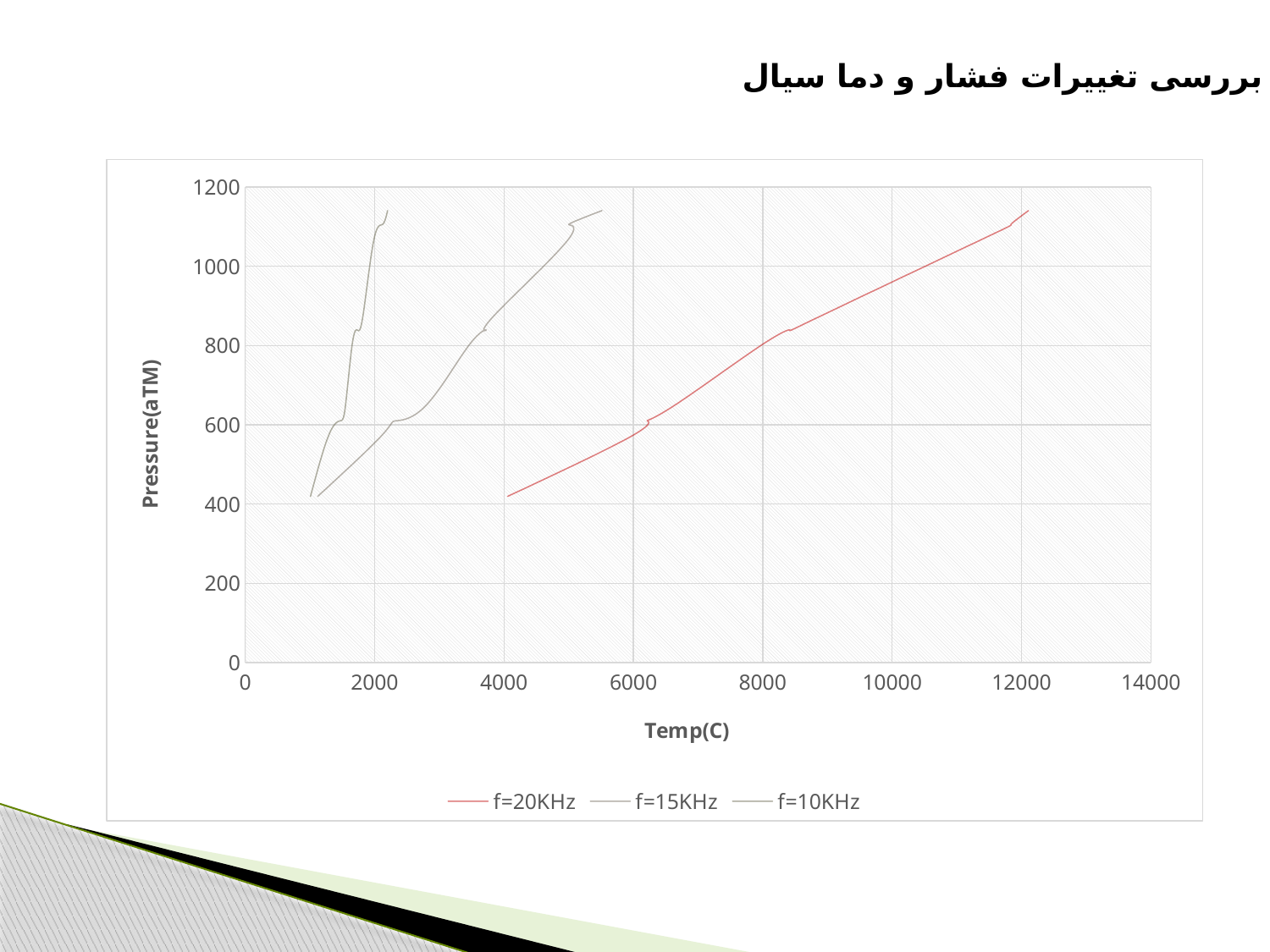
Which series extends to the highest temperature on the x axis? f=20KHz Is the highest pressure reached by the f=20KHz series greater or less than 1000? greater How many series does the legend list? 3 Does pressure rise or fall as temperature increases for the f=15KHz series? rise Is the pressure of the f=20KHz series at a temperature of 10000 greater or less than 800? greater Which series stays at the lowest temperatures on the x axis? f=10KHz What are the three series named in the legend? f=20KHz, f=15KHz, f=10KHz Does pressure rise or fall as temperature increases for the f=20KHz series? rise Is the highest temperature reached by the f=10KHz series greater or less than 4000? less What is the title of the x axis? Temp(C) What kind of chart is shown on the slide? line chart